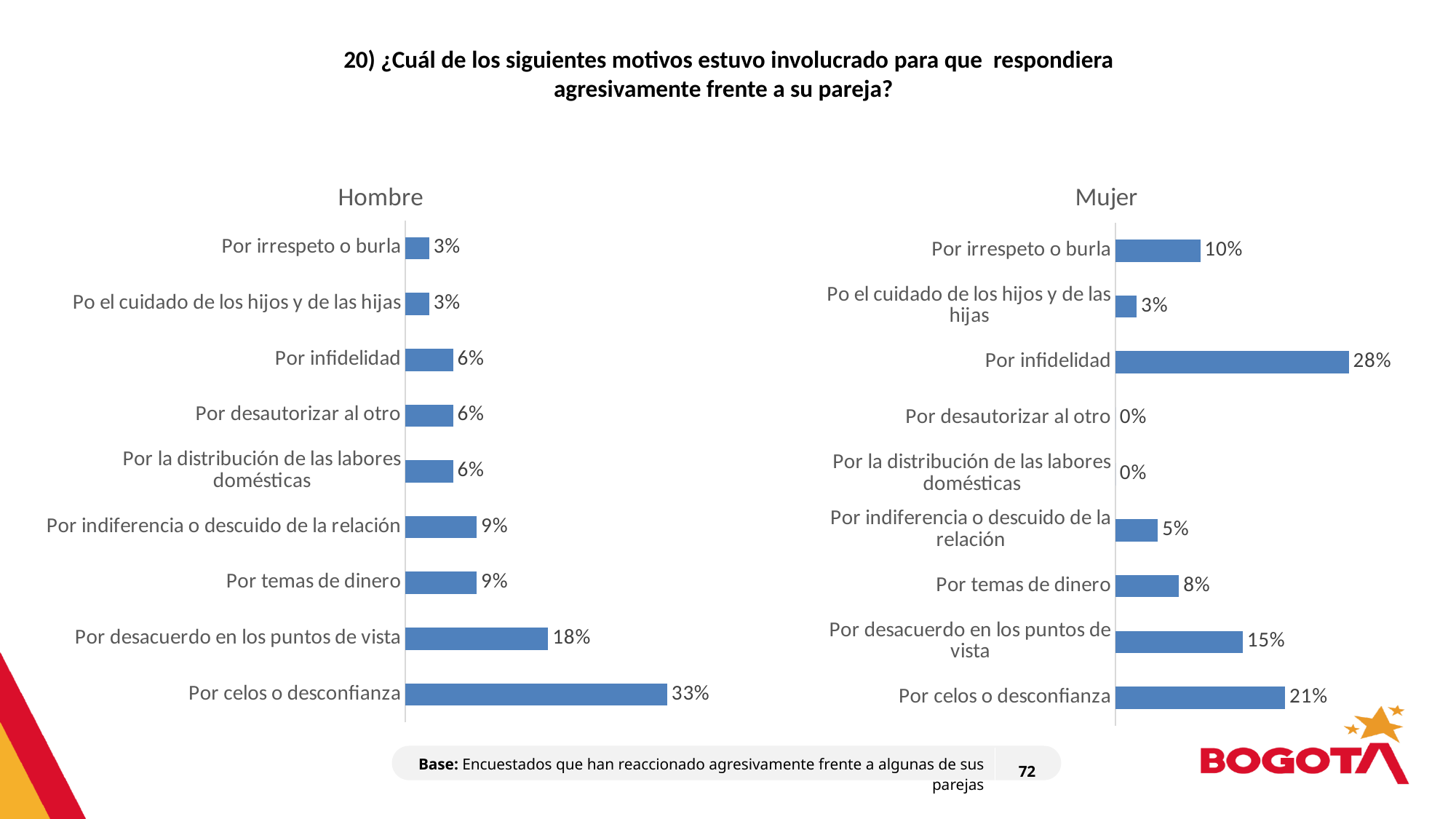
In the Mujer chart, which category has the highest value? Por infidelidad Which is larger: Por temas de dinero in the Hombre chart or Por temas de dinero in the Mujer chart? Hombre In the Mujer chart, what is the value for Por irrespeto o burla? 10% In the Hombre chart, which category has the highest value? Por celos o desconfianza In the Mujer chart, what is the difference between Por infidelidad and Por celos o desconfianza? 7% In the Mujer chart, how many categories have a value of 0%? 2 In the Mujer chart, what is the value for Por infidelidad? 28% In the Hombre chart, what is the value for Por celos o desconfianza? 33% In the Mujer chart, which is larger: Por desacuerdo en los puntos de vista or Por irrespeto o burla? Por desacuerdo en los puntos de vista In the Hombre chart, what is the difference between Por celos o desconfianza and Por desacuerdo en los puntos de vista? 15% What kind of chart is the Mujer chart? Bar chart How many categories are shown in the Hombre chart? 9